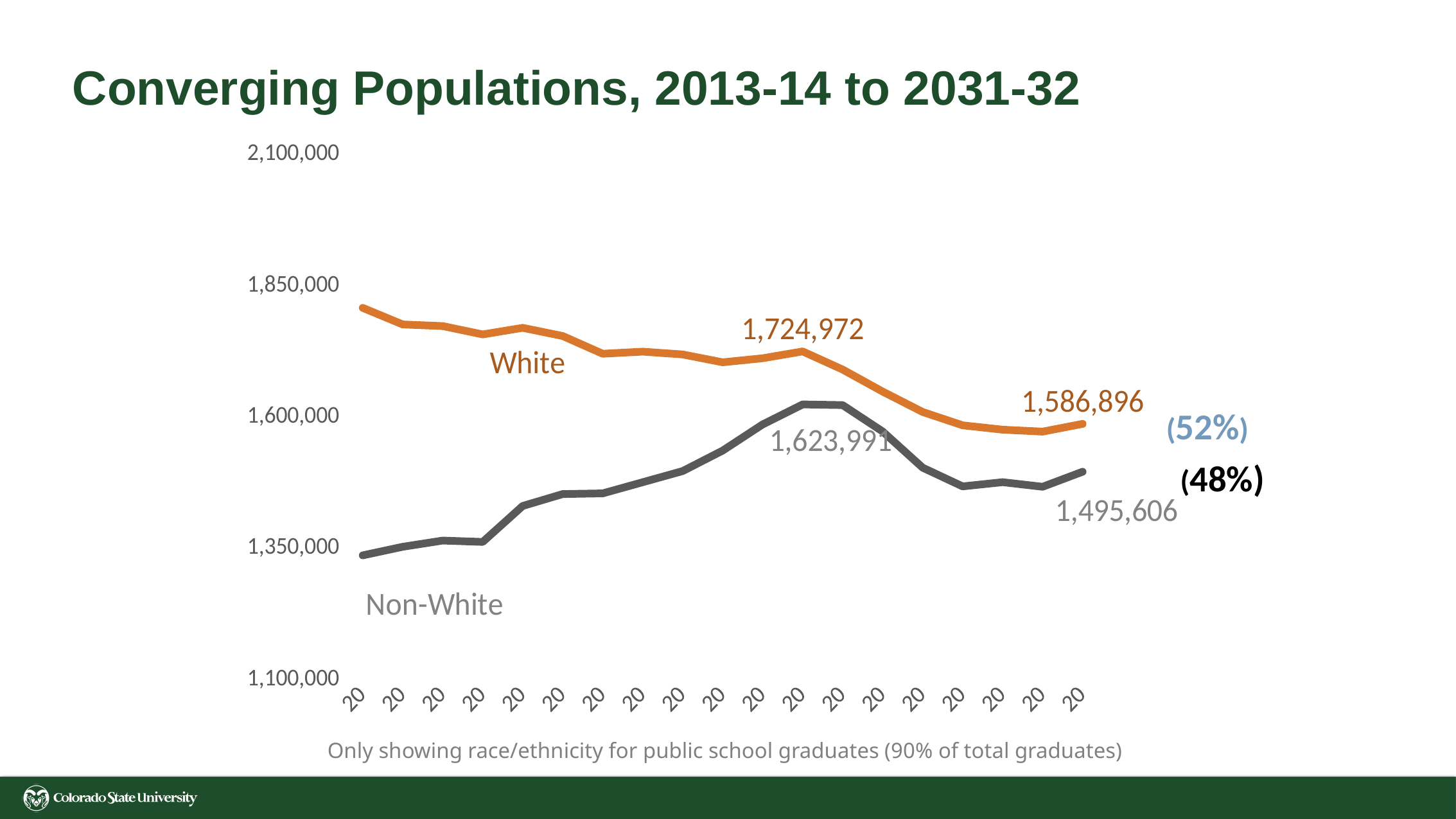
What is the difference between the final labelled values of the White and Non-White series? 91,290 What is the final labelled value for the Non-White series? 1,495,606 What percentage share is shown next to the end of the White line? 52% How many series are plotted on the chart? 2 What is the title of the chart? Converging Populations, 2013-14 to 2031-32 Which series has the larger final labelled value, White or Non-White? White What kind of chart is shown on the slide? Line chart What is the peak labelled value for the Non-White series? 1,623,991 Is the first value of the White series greater or less than 1,600,000? greater Does the White series generally rise or fall from left to right? Fall What is the final labelled value for the White series? 1,586,896 What is the labelled value on the White line near the middle of the chart? 1,724,972